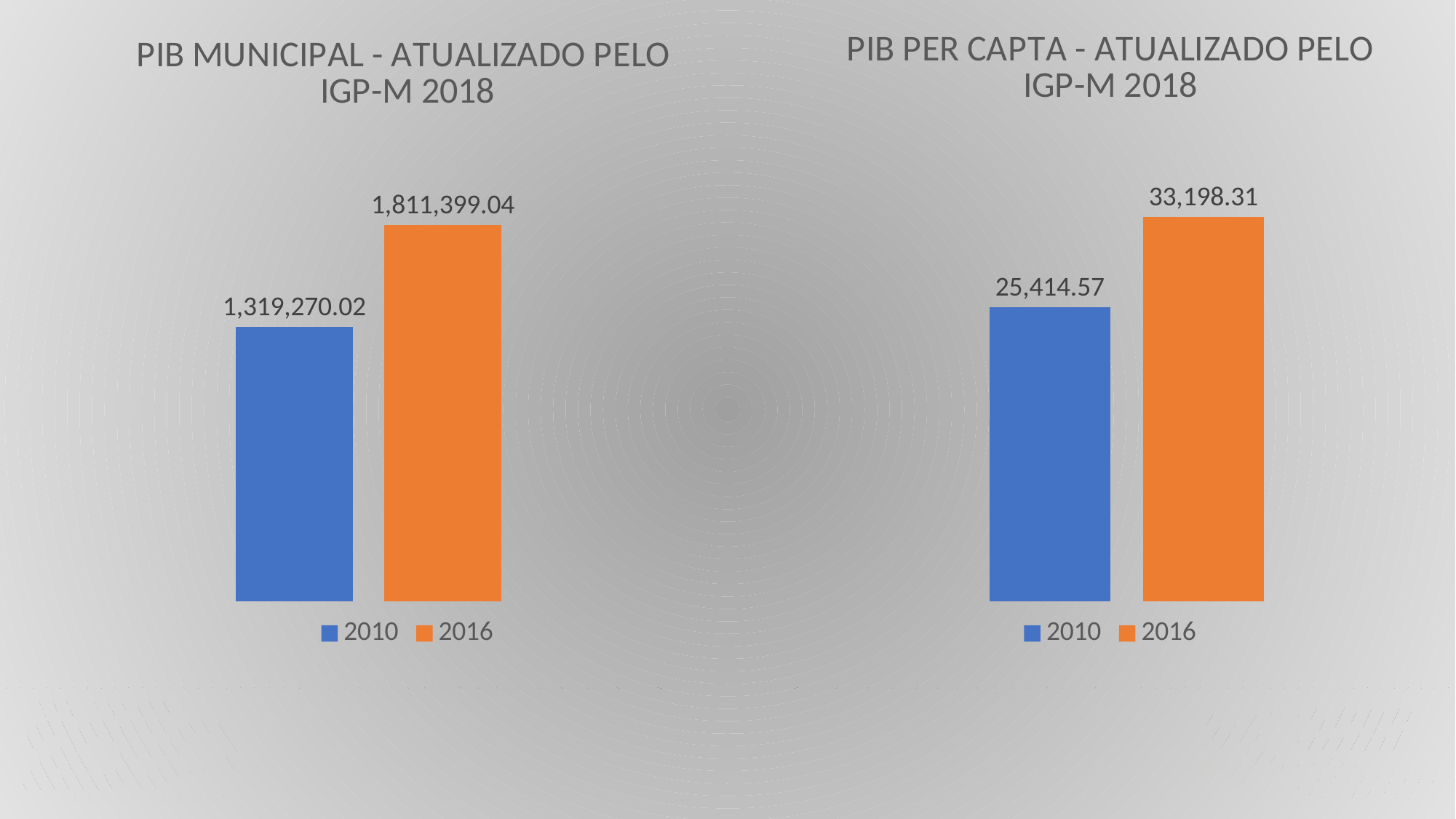
In the PIB PER CAPTA - ATUALIZADO PELO IGP-M 2018 chart, what is the difference between the 2016 and 2010 values? 7,783.74 In the PIB PER CAPTA - ATUALIZADO PELO IGP-M 2018 chart, is the value for 2010 larger or smaller than the value for 2016? smaller In the PIB MUNICIPAL - ATUALIZADO PELO IGP-M 2018 chart, what is the value for 2016? 1,811,399.04 In the PIB PER CAPTA - ATUALIZADO PELO IGP-M 2018 chart, what is the value for 2010? 25,414.57 In the PIB MUNICIPAL - ATUALIZADO PELO IGP-M 2018 chart, which year has the higher value? 2016 In the PIB MUNICIPAL - ATUALIZADO PELO IGP-M 2018 chart, what is the difference between the 2016 and 2010 values? 492,129.02 In the PIB MUNICIPAL - ATUALIZADO PELO IGP-M 2018 chart, what is the value for 2010? 1,319,270.02 In the PIB PER CAPTA - ATUALIZADO PELO IGP-M 2018 chart, what is the value for 2016? 33,198.31 In the PIB MUNICIPAL - ATUALIZADO PELO IGP-M 2018 chart, what colour is the bar for 2016? orange What kind of chart is the PIB PER CAPTA - ATUALIZADO PELO IGP-M 2018 chart? bar chart In the PIB PER CAPTA - ATUALIZADO PELO IGP-M 2018 chart, which year has the lower value? 2010 How many series does the legend of the PIB MUNICIPAL - ATUALIZADO PELO IGP-M 2018 chart list? 2